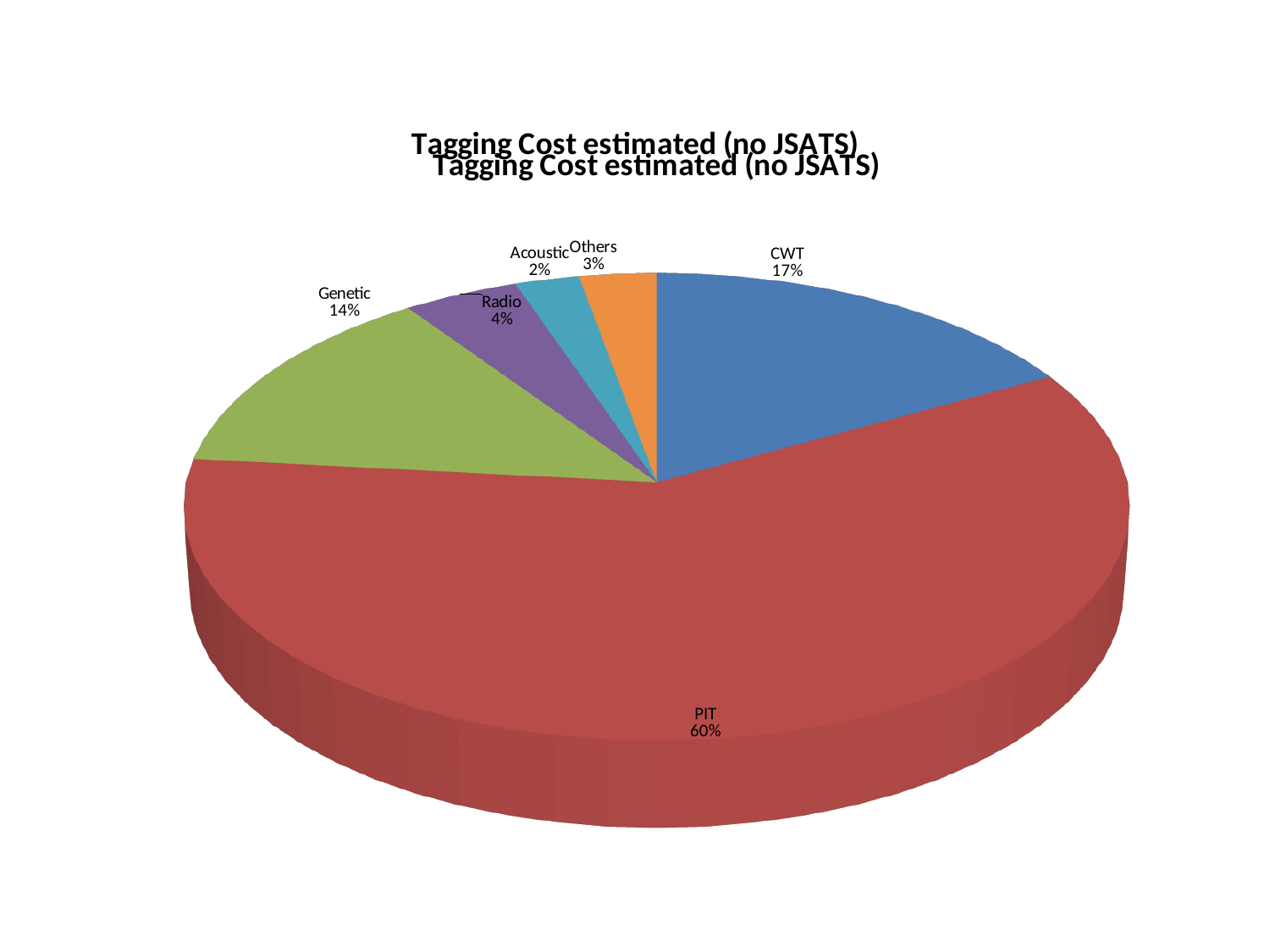
What is the title of the chart? Tagging Cost estimated (no JSATS) What share of the pie does Radio account for? 4% Which slice is larger, Genetic or CWT? CWT What share of the pie does PIT account for? 60% Which category has the largest slice of the pie? PIT What share of the pie does Genetic account for? 14% What kind of chart is shown on the slide? pie chart Which category has the smallest slice of the pie? Acoustic How many slices does the pie chart have? 6 What is the difference in percentage points between the PIT and CWT slices? 43